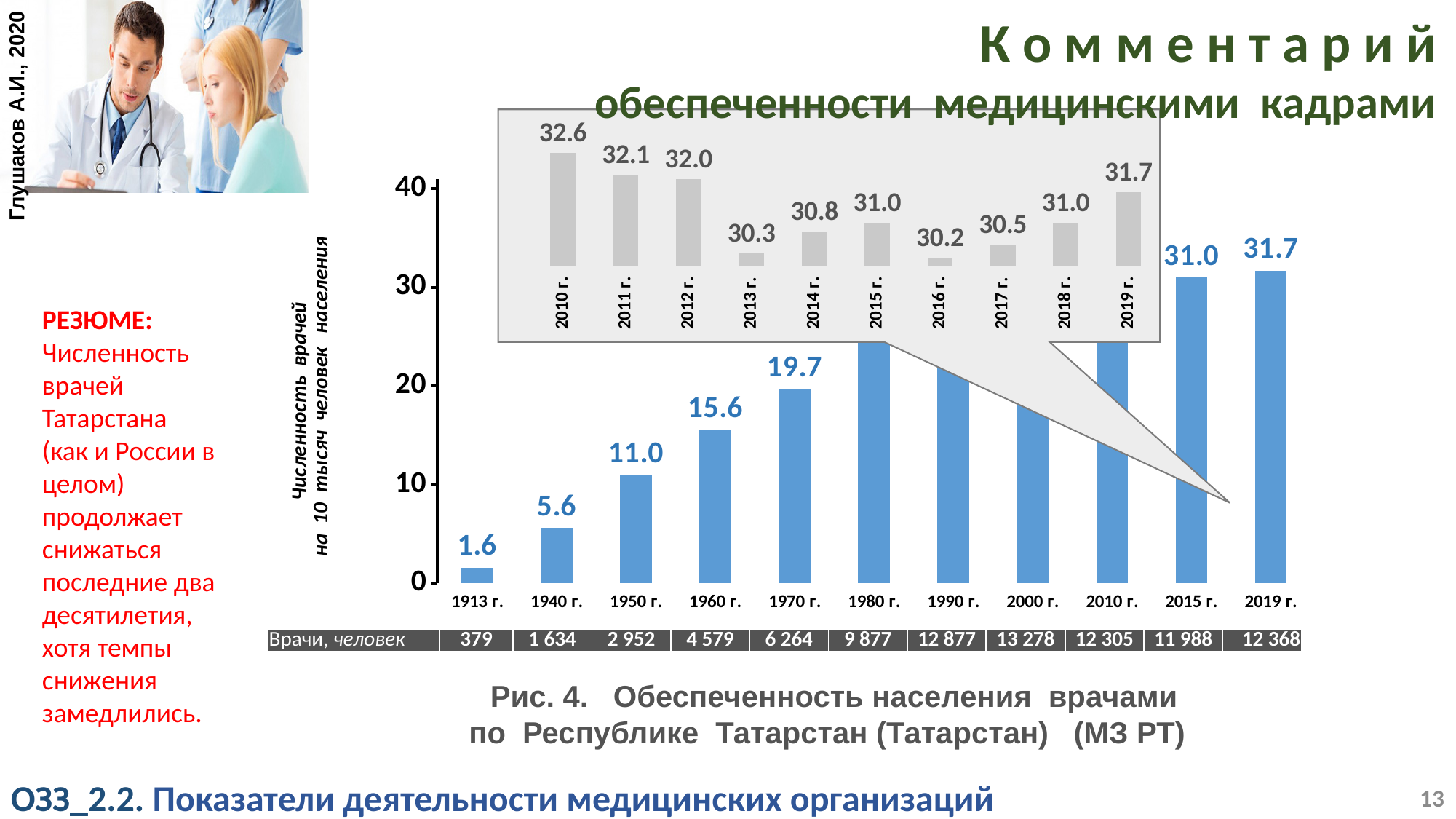
On the inset chart in the callout, which is larger, the value for 2013 г. or 2014 г.? 2014 г. On the main chart, which year has the lowest value? 1913 г. On the main chart, how many years are shown on the x axis? 11 On the main chart, is the value for 1960 г. greater or less than 20? less On the main chart, what is the value for 1913 г.? 1.6 On the main chart, do the values rise or fall from 1913 г. to 1970 г.? rise On the main chart, what is the value for 1970 г.? 19.7 On the inset chart in the callout, which year has the highest value? 2010 г. On the inset chart in the callout, what is the value for 2016 г.? 30.2 On the main chart, what is the value for 2019 г.? 31.7 What kind of chart is the main chart? bar chart On the main chart, what is the difference between the values for 1960 г. and 1950 г.? 4.6